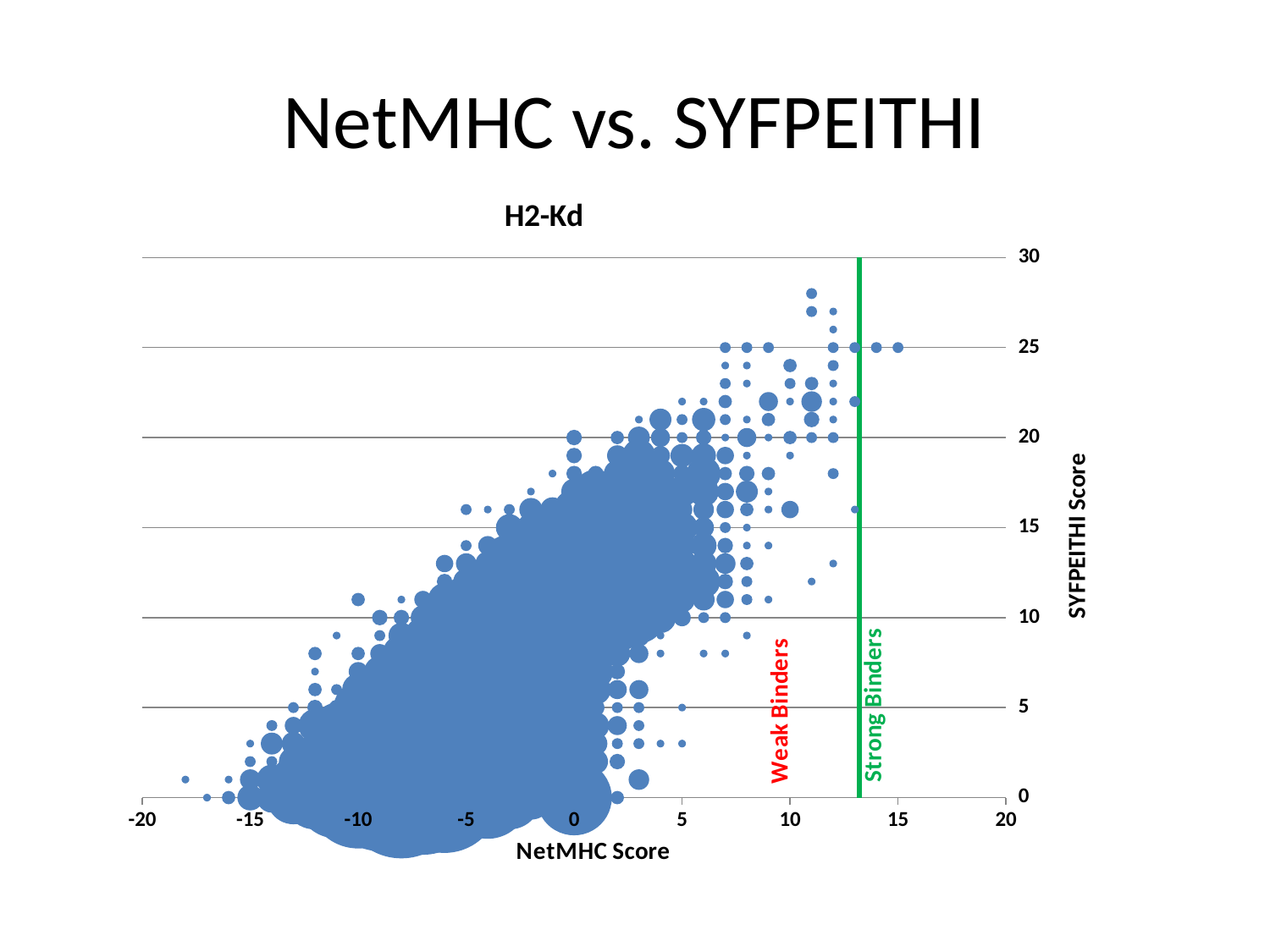
What label is shown on the x axis of the chart? NetMHC Score What is the highest value shown on the y axis (SYFPEITHI Score)? 30 As the NetMHC Score increases along the x axis, do the SYFPEITHI Score values generally rise or fall? rise What is the title of the chart? H2-Kd What is the lowest value shown on the x axis (NetMHC Score)? -20 What kind of chart is shown on the slide? scatter (bubble) chart